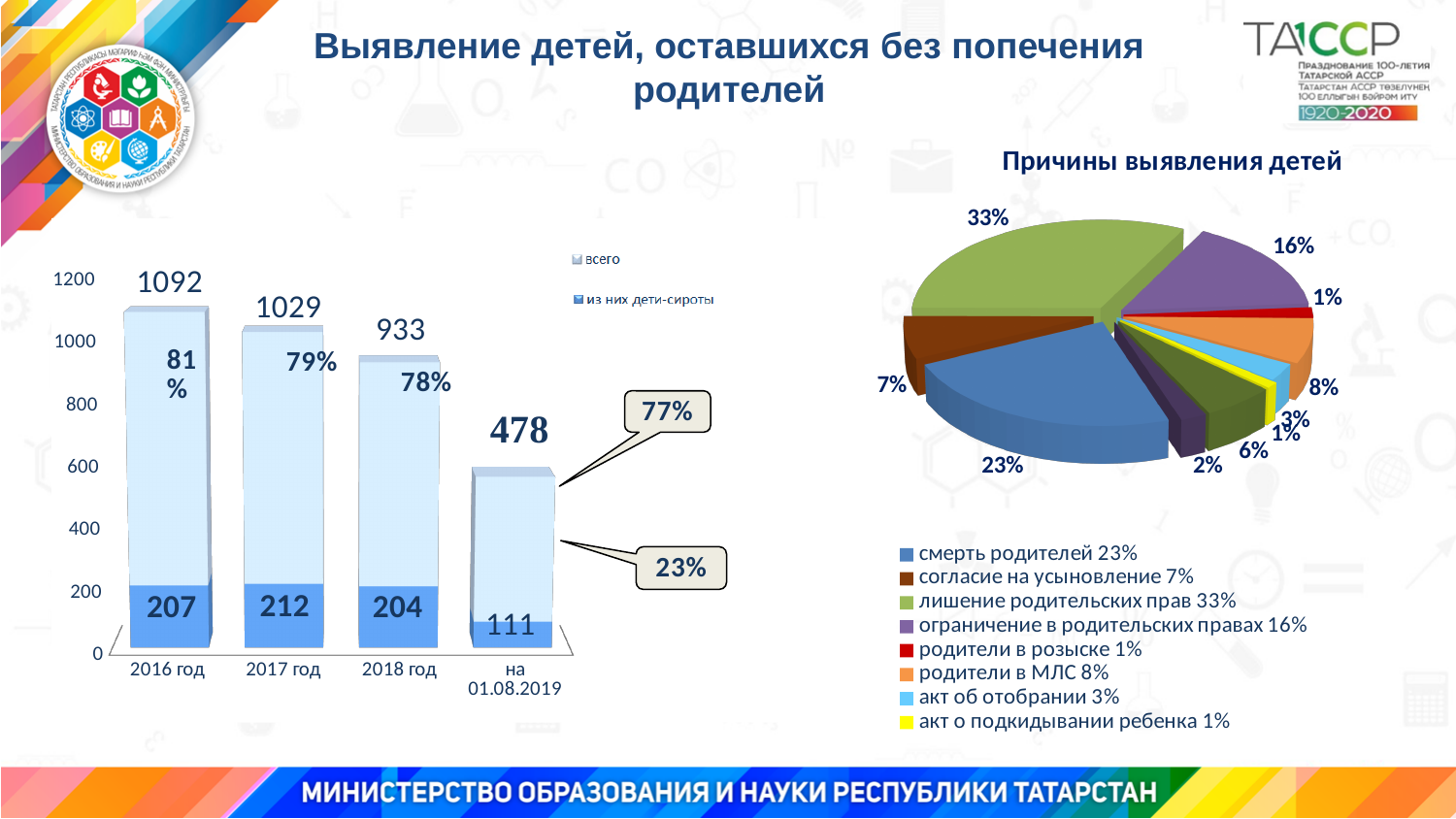
In the pie chart 'Причины выявления детей', which is larger: 'смерть родителей' or 'ограничение в родительских правах'? смерть родителей In the bar chart on the left, what is the 'всего' value for 'на 01.08.2019'? 478 In the bar chart on the left, what is the value of the 'всего' series for 2016 год? 1092 In the bar chart on the left, which year has the highest 'всего' value? 2016 год In the bar chart on the left, what is the difference between the 'всего' values for 2017 год and 2018 год? 96 What is the title of the pie chart on the right of the slide? Причины выявления детей In the bar chart on the left, does the 'всего' value rise or fall from 2016 год to 2018 год? fall In the bar chart on the left, how many series does the legend list? 2 In the bar chart on the left, which category has the lowest 'из них дети-сироты' value? на 01.08.2019 In the bar chart on the left, what is the value of the 'из них дети-сироты' series for 2017 год? 212 What kind of chart is the chart on the left of the slide? bar chart In the pie chart 'Причины выявления детей', what share is 'лишение родительских прав'? 33%